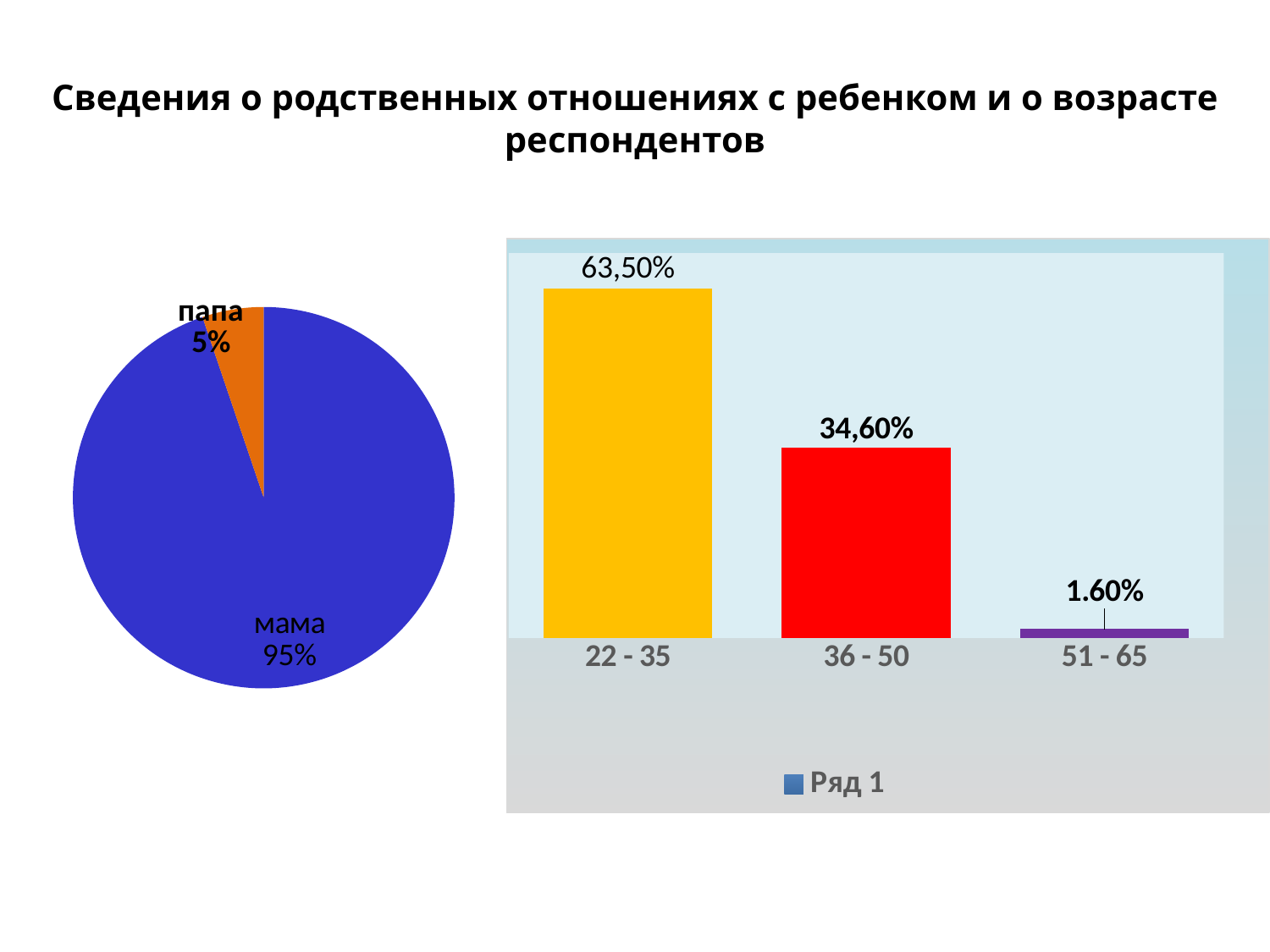
In the pie chart on the left, which slice is the largest? мама In the bar chart on the right, what is the name of the series listed in the legend? Ряд 1 In the pie chart on the left, how many slices are there? 2 In the bar chart on the right, what is the value for 22 - 35? 63,50% What kind of chart is the chart on the left? pie chart In the bar chart on the right, what is the value for 36 - 50? 34,60% In the bar chart on the right, which is larger, the value for 22 - 35 or the value for 36 - 50? 22 - 35 In the pie chart on the left, what share is labelled for папа? 5% In the bar chart on the right, which age group has the lowest value? 51 - 65 In the bar chart on the right, how many age groups are shown? 3 In the pie chart on the left, what share is labelled for мама? 95% In the bar chart on the right, what is the value for 51 - 65? 1.60%